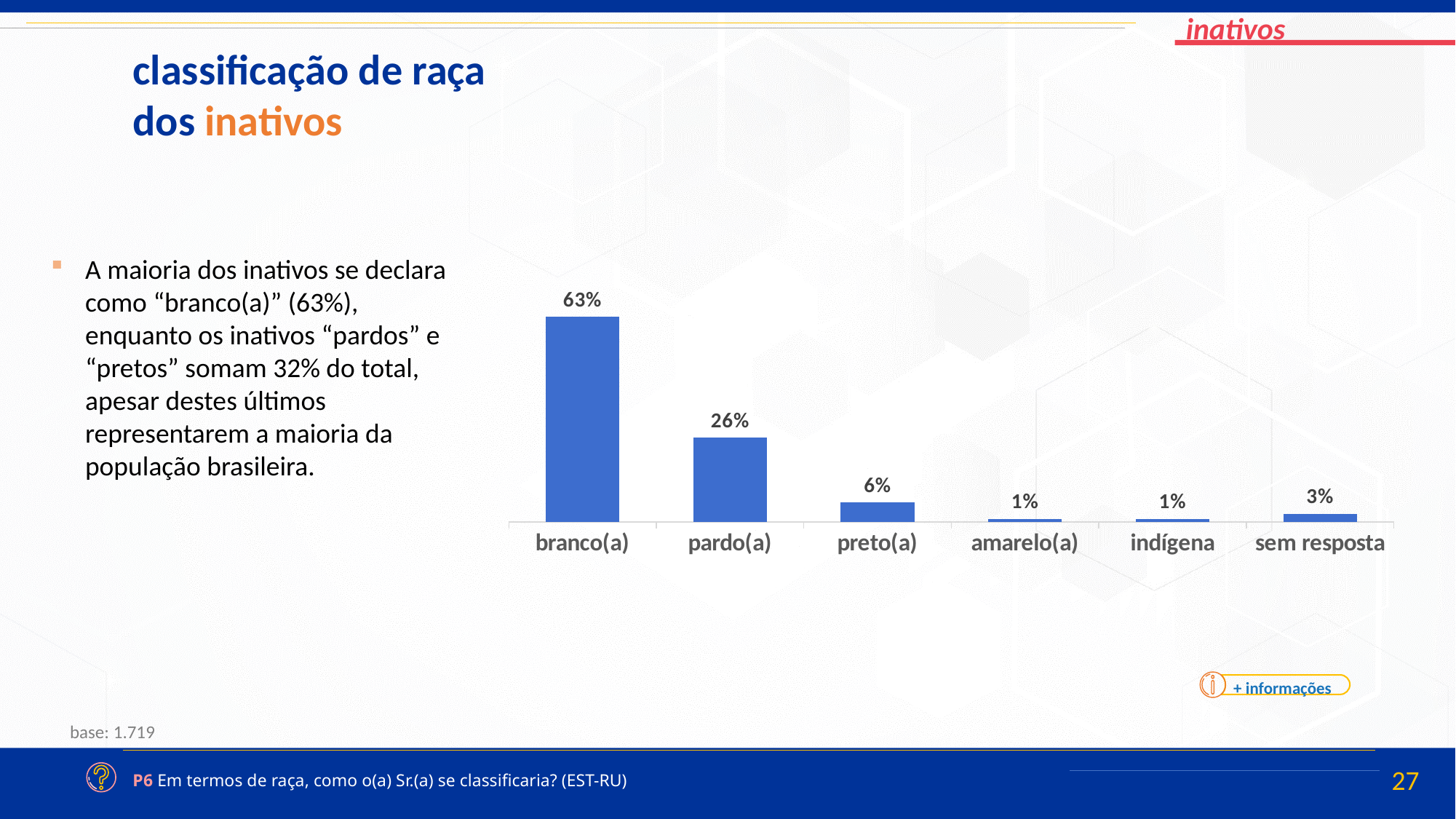
What is the value shown for sem resposta? 3% Which is larger, the value for preto(a) or the value for sem resposta? preto(a) What is the base (sample size) noted on the slide? 1.719 How many categories are shown on the x axis? 6 What is the value shown for pardo(a)? 26% What kind of chart is shown on the slide? bar chart What is the combined value of pardo(a) and preto(a)? 32% Which category has the highest value? branco(a) What is the difference between the values for branco(a) and pardo(a)? 37 percentage points What is the value shown for preto(a)? 6% Which two categories share the same value of 1%? amarelo(a) and indígena What percentage of inativos classify themselves as branco(a)? 63%